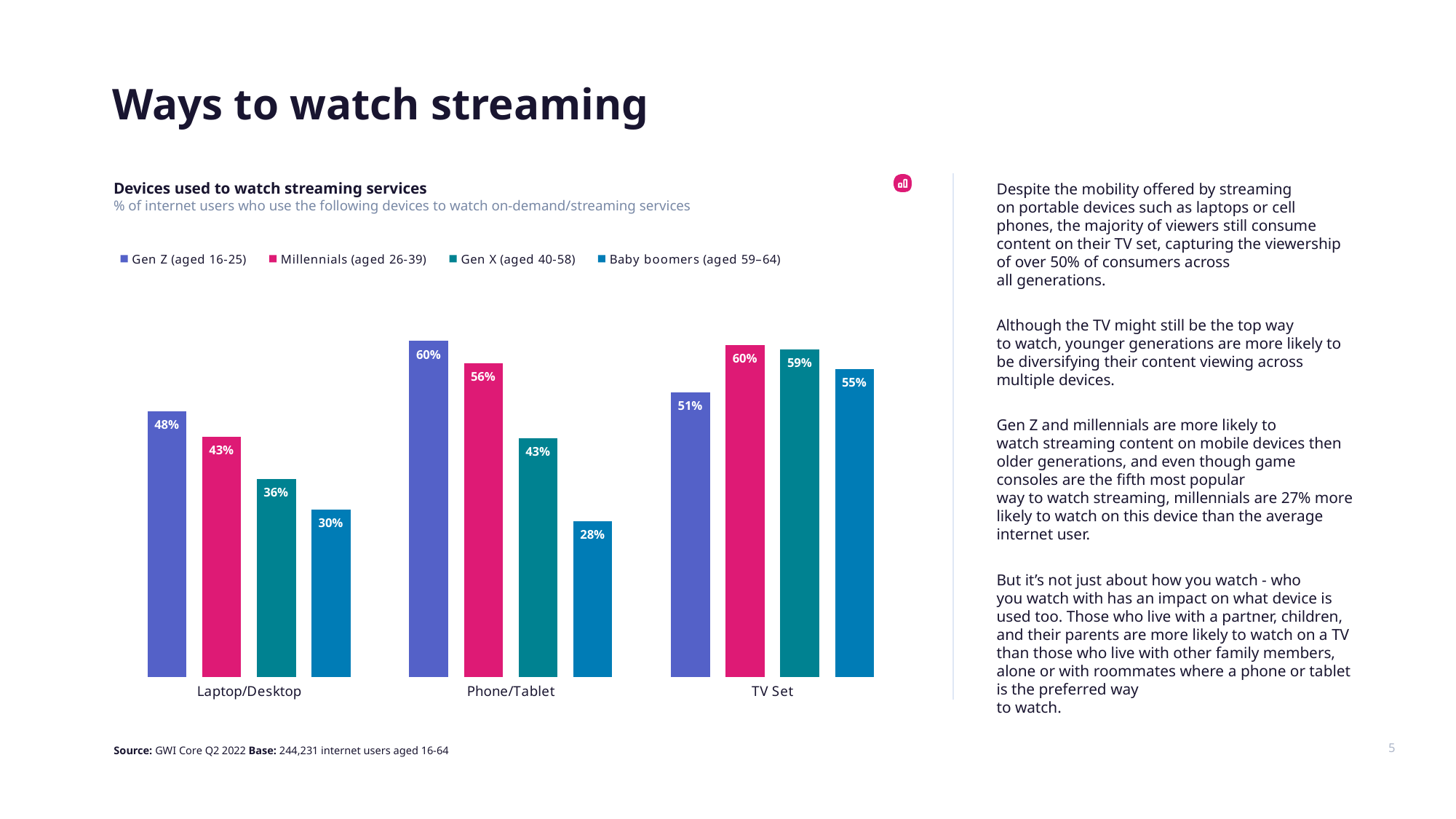
What is the difference between the Millennials values for TV Set and Laptop/Desktop? 17 percentage points Which is larger: the Gen Z value for TV Set or the Gen X value for TV Set? Gen X value for TV Set What is the difference between the Gen Z and Baby boomers values for Phone/Tablet? 32 percentage points What percentage of Gen Z (aged 16-25) use a Phone/Tablet to watch streaming services? 60% What kind of chart is shown on the slide? Bar chart Which device category has the highest value for Baby boomers (aged 59–64)? TV Set What percentage of Baby boomers (aged 59–64) use a Laptop/Desktop to watch streaming services? 30% How many device categories are shown on the x axis? 3 Which generation has the lowest value for Phone/Tablet? Baby boomers (aged 59–64) What is the title of the chart? Devices used to watch streaming services What is the value for Gen X (aged 40-58) in the TV Set category? 59% How many series does the legend list? 4